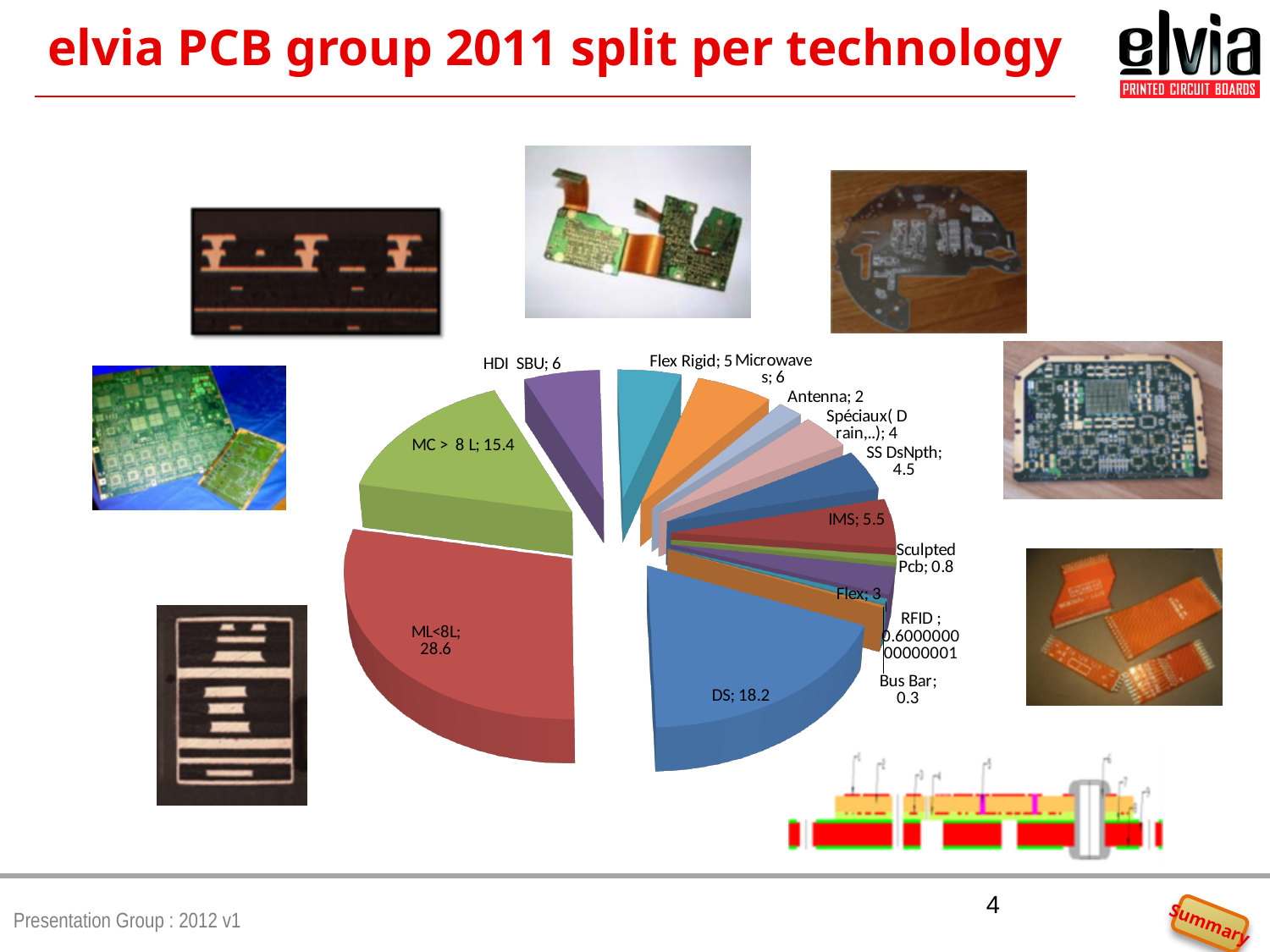
Which category has the largest slice in the pie chart? ML<8L Which is larger, the value for DS or the value for MC > 8 L? DS What is the title of the slide containing the pie chart? elvia PCB group 2011 split per technology What kind of chart is shown on the slide? pie chart Which category has the smallest slice in the pie chart? Bus Bar What is the value for IMS in the pie chart? 5.5 What is the difference between the values for ML<8L and DS? 10.4 What is the value for ML<8L in the pie chart? 28.6 What is the value for Sculpted Pcb in the pie chart? 0.8 What is the value for DS in the pie chart? 18.2 How many categories are shown in the pie chart? 14 What is the value for MC > 8 L in the pie chart? 15.4